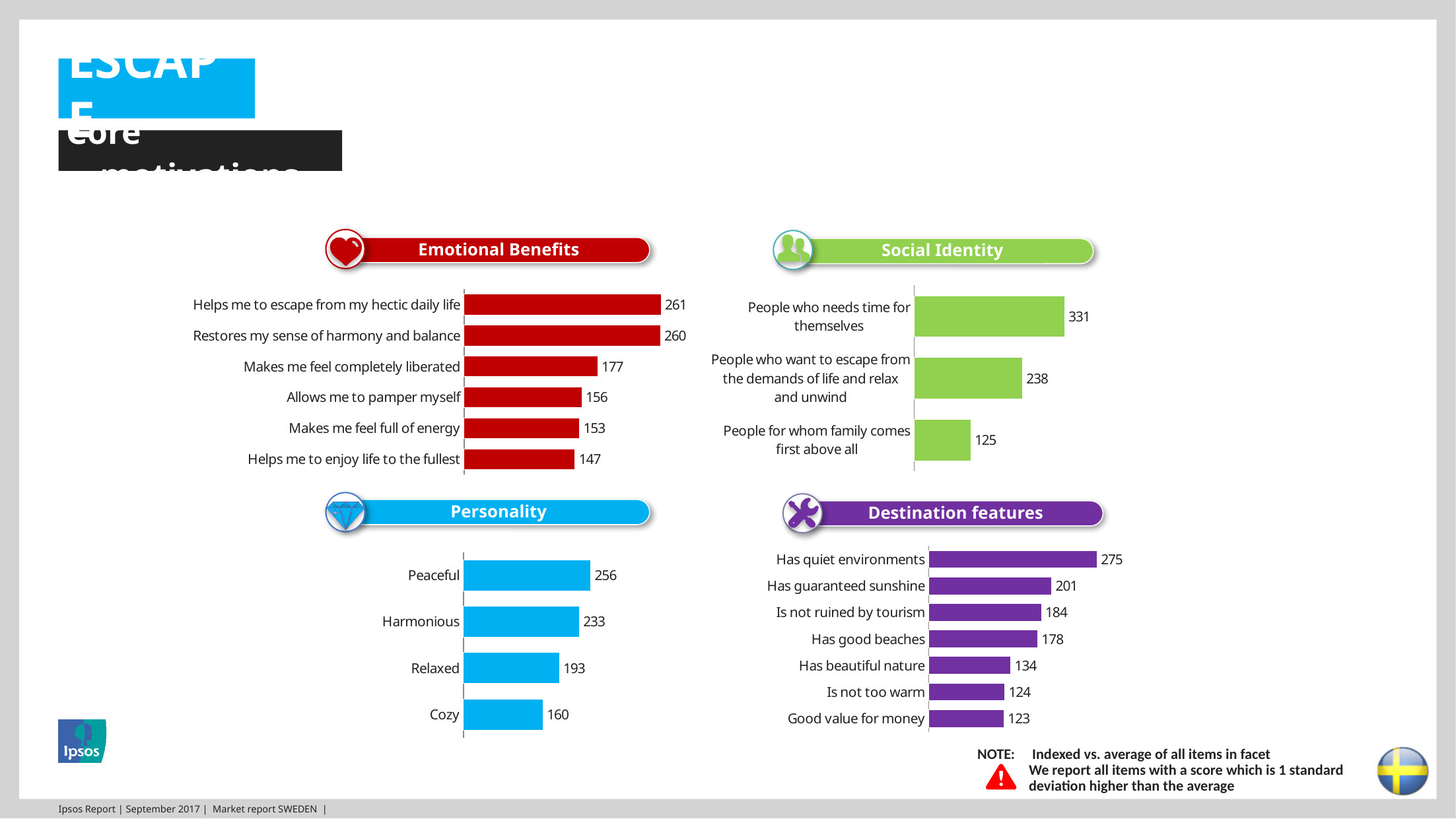
In the Social Identity chart, what is the value for "People who needs time for themselves"? 331 In the Emotional Benefits chart, which item has the lowest value? Helps me to enjoy life to the fullest In the Destination features chart, what is the difference between "Has quiet environments" and "Good value for money"? 152 In the Personality chart, what is the value for "Relaxed"? 193 In the Social Identity chart, what is the difference between "People who want to escape from the demands of life and relax and unwind" and "People for whom family comes first above all"? 113 In the Emotional Benefits chart, how many items are plotted? 6 What type of chart is the Destination features chart? Bar chart In the Personality chart, how many traits are plotted? 4 In the Destination features chart, what is the value for "Has good beaches"? 178 In the Personality chart, which trait has the highest value? Peaceful In the Emotional Benefits chart, what is the value for "Makes me feel completely liberated"? 177 In the Destination features chart, which is larger: "Has guaranteed sunshine" or "Is not ruined by tourism"? Has guaranteed sunshine